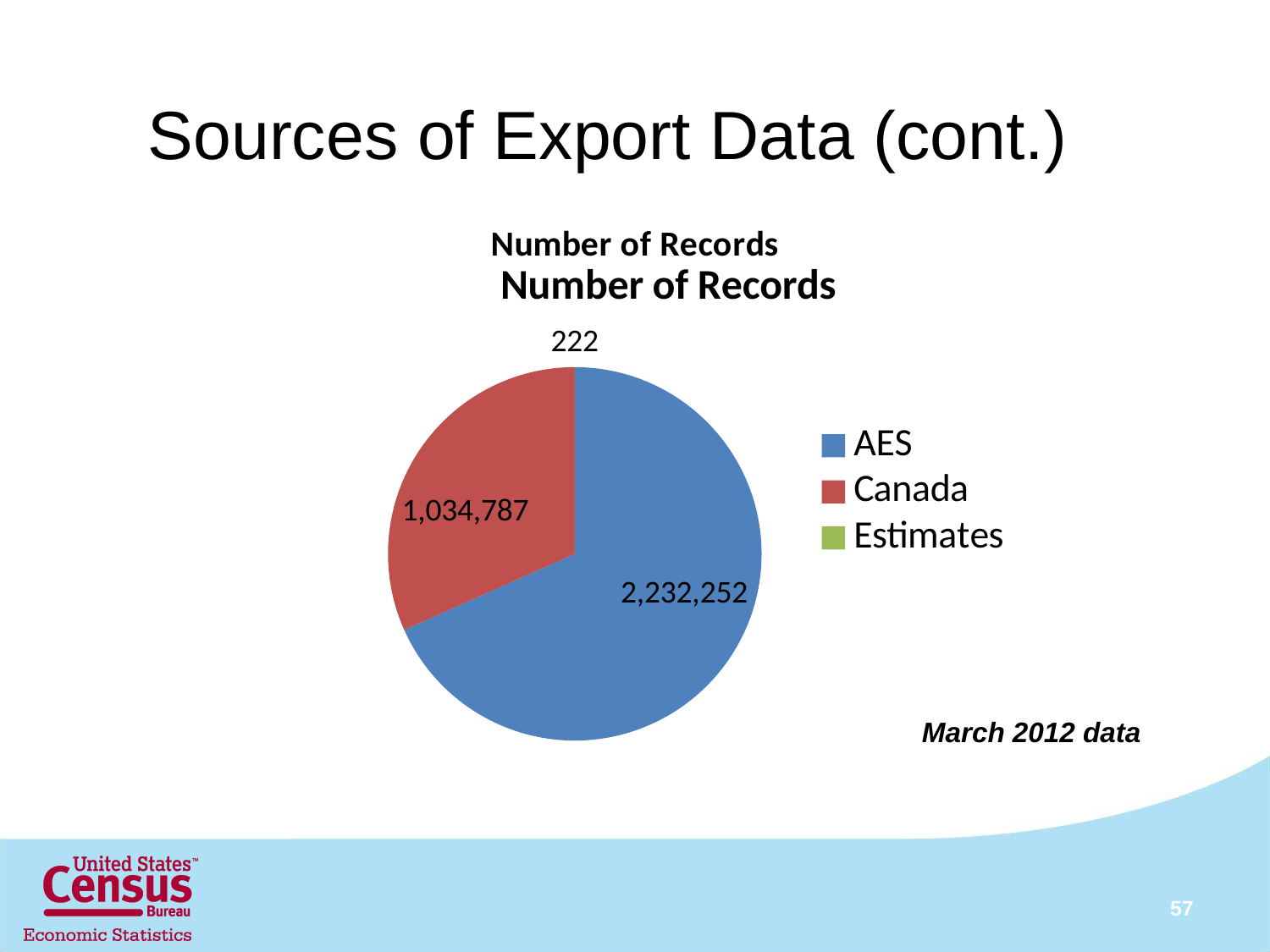
What is the number of records for AES? 2,232,252 What is the number of records for Estimates? 222 Which colour represents Canada in the pie chart? Red How many entries does the legend list? 3 What is the number of records for Canada? 1,034,787 Which source has the largest number of records? AES What type of chart is shown on the slide? Pie chart What is the total number of records across all three sources? 3,267,261 What is the difference in number of records between AES and Canada? 1,197,465 What is the title of the chart? Number of Records Which source has the smallest number of records? Estimates Which has more records, AES or Canada? AES